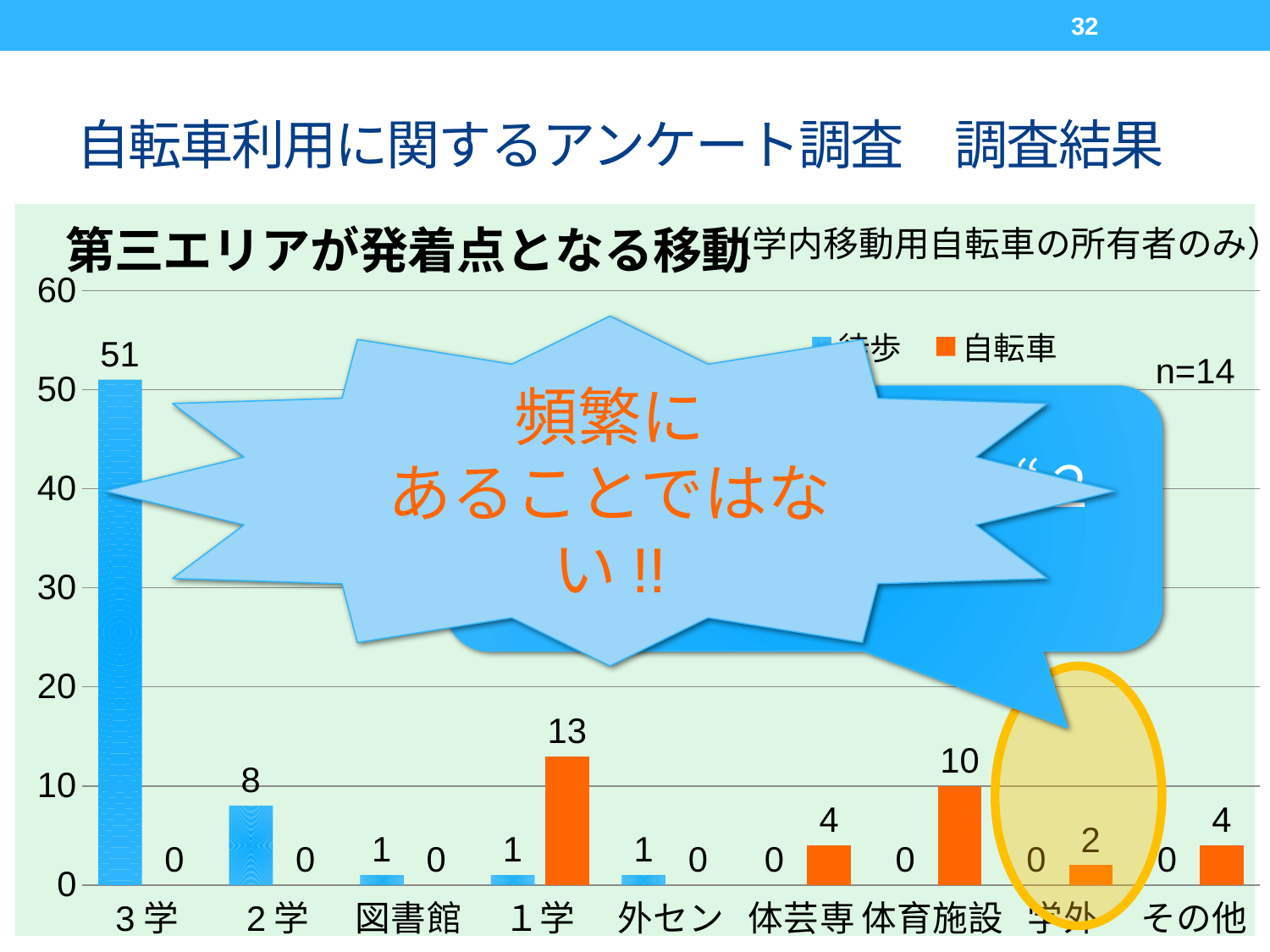
What is the value of the blue bar for 3学? 51 What is the 自転車 value for 体育施設? 10 What kind of chart is shown? bar chart Which category has the highest 自転車 value? 1学 What is the value of the blue bar for 2学? 8 What is the total of the blue and orange values for 1学? 14 How many categories are shown on the x axis? 9 What is the difference between the 自転車 values for 1学 and 体育施設? 3 What sample size (n) is shown on the chart? n=14 What is the 自転車 value for 1学? 13 Which is larger, the 自転車 value for 体芸専 or for 学外? 体芸専 How many series does the legend list? 2